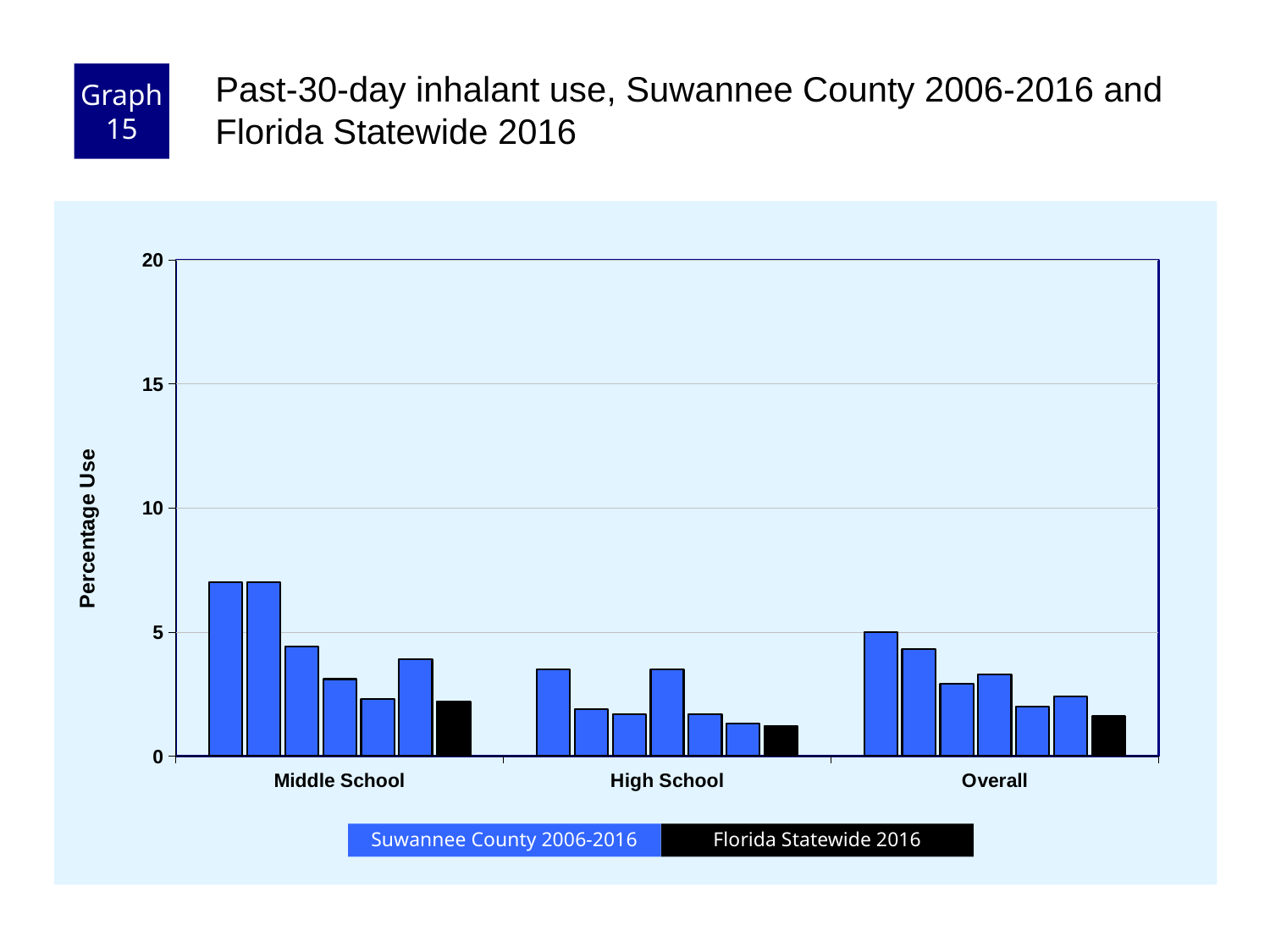
What kind of chart is shown on the slide? bar chart Is the Florida Statewide 2016 value for Middle School greater or less than 5? less Which group contains the tallest bar on the chart? Middle School What is the label on the y axis? Percentage Use Do the Suwannee County 2006-2016 bars in the Overall group generally rise or fall from left to right? fall Is the value of the first Suwannee County bar in the Middle School group greater or less than 5? greater How many series does the legend list? 2 How many category groups are shown on the x axis? 3 Is the Florida Statewide 2016 value for High School greater or less than 5? less Which is larger, the Florida Statewide 2016 bar for Middle School or the Florida Statewide 2016 bar for High School? Middle School Which group has the lowest Florida Statewide 2016 bar? High School How many bars are plotted in the Middle School group? 7